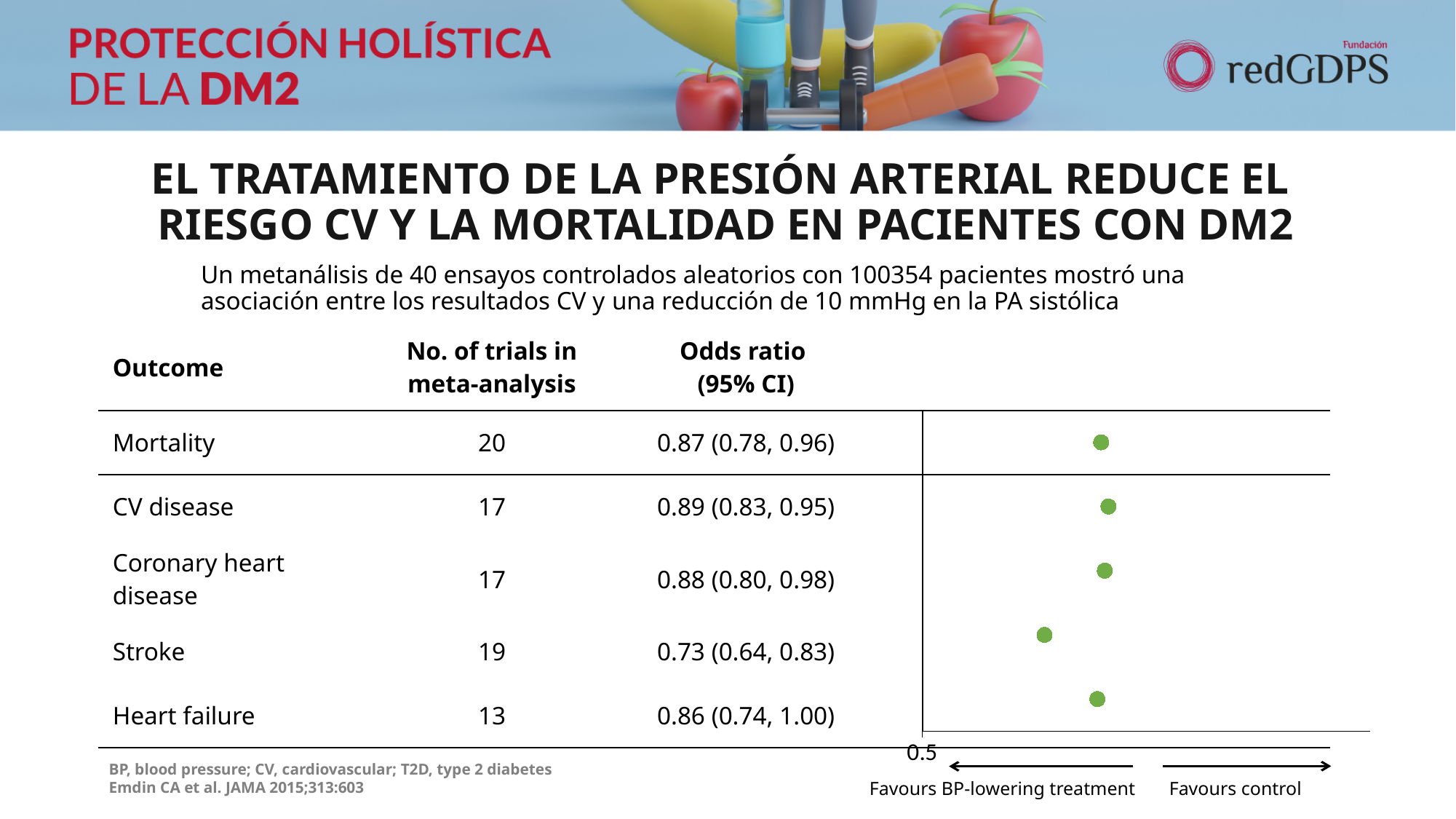
How many outcomes are plotted in the chart? 5 Is the odds ratio for Stroke greater or less than 0.5? greater What is the odds ratio for Stroke? 0.73 What is the 95% CI for Heart failure? (0.74, 1.00) What is the difference between the number of trials for Mortality and for Heart failure? 7 Which outcome has the lowest odds ratio? Stroke Which outcome has the highest number of trials in the meta-analysis? Mortality What is the odds ratio for Coronary heart disease? 0.88 How many trials in the meta-analysis are listed for Heart failure? 13 What label appears under the left-pointing arrow below the chart? Favours BP-lowering treatment How many trials are listed for Stroke? 19 Which has the larger odds ratio, Stroke or Mortality? Mortality